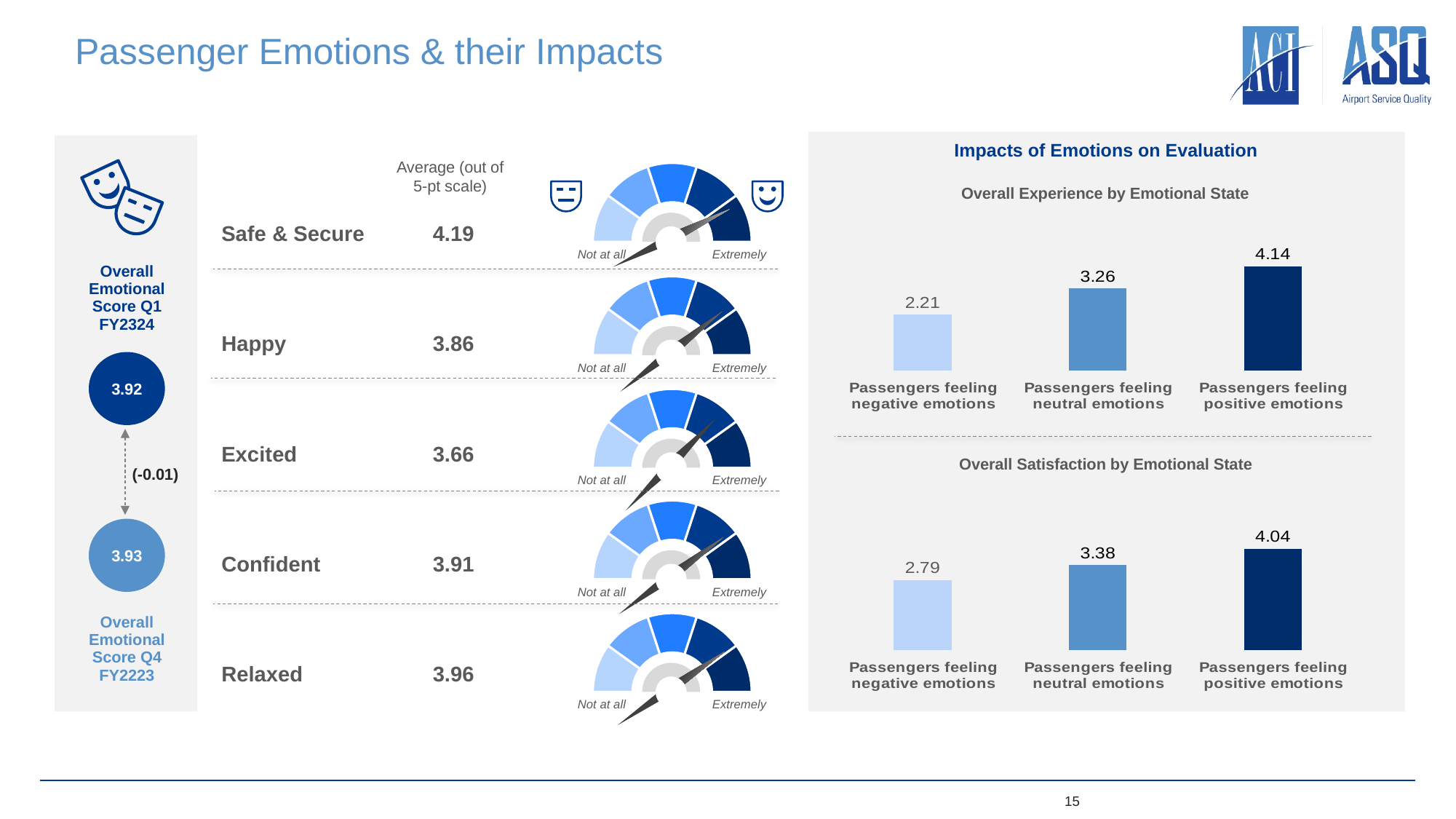
How many categories are shown in the 'Overall Satisfaction by Emotional State' chart? 3 In the 'Overall Satisfaction by Emotional State' chart, do the values rise or fall from negative to positive emotions? Rise In the 'Overall Satisfaction by Emotional State' chart, which emotional state has the lowest value? Passengers feeling negative emotions In the 'Overall Experience by Emotional State' chart, what is the value for passengers feeling positive emotions? 4.14 Which is larger: the negative-emotions value in the 'Overall Experience by Emotional State' chart or the negative-emotions value in the 'Overall Satisfaction by Emotional State' chart? Overall Satisfaction by Emotional State (2.79) In the 'Overall Satisfaction by Emotional State' chart, what is the difference between the values for positive and neutral emotions? 0.66 What is the title of the panel containing the two bar charts on the right of the slide? Impacts of Emotions on Evaluation In the 'Overall Satisfaction by Emotional State' chart, what is the value for passengers feeling neutral emotions? 3.38 In the 'Overall Experience by Emotional State' chart, what is the difference between the values for positive and negative emotions? 1.93 In the 'Overall Experience by Emotional State' chart, which emotional state has the highest value? Passengers feeling positive emotions In the 'Overall Experience by Emotional State' chart, what is the value for passengers feeling negative emotions? 2.21 What kind of chart is 'Overall Experience by Emotional State'? Bar chart